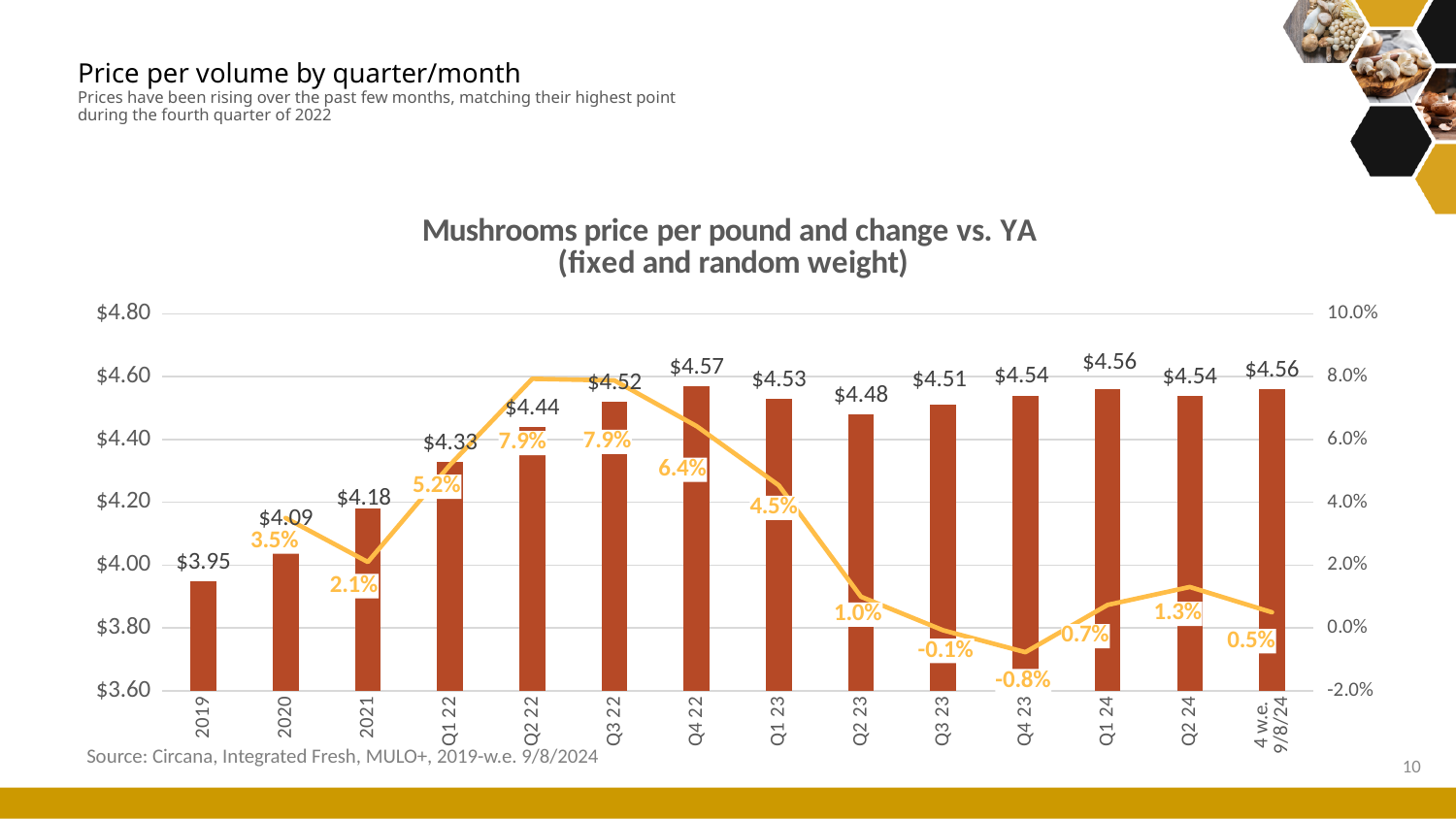
Which period has the lowest change vs. YA? Q4 23 What kind of chart is this? Combination bar and line chart Which period has the lowest price per pound? 2019 How many periods are shown on the x axis? 14 Does the price per pound rise or fall from 2019 to Q4 22? Rise Which is higher, the price per pound for Q1 22 or for Q2 23? Q2 23 What is the difference in price per pound between Q4 22 and 2019? $0.62 Which period has the highest price per pound? Q4 22 What is the change vs. YA shown for Q4 23? -0.8% What is the mushroom price per pound for Q4 22? $4.57 What is the price per pound shown for 2019? $3.95 What is the change vs. YA shown for the 4 w.e. 9/8/24 period? 0.5%